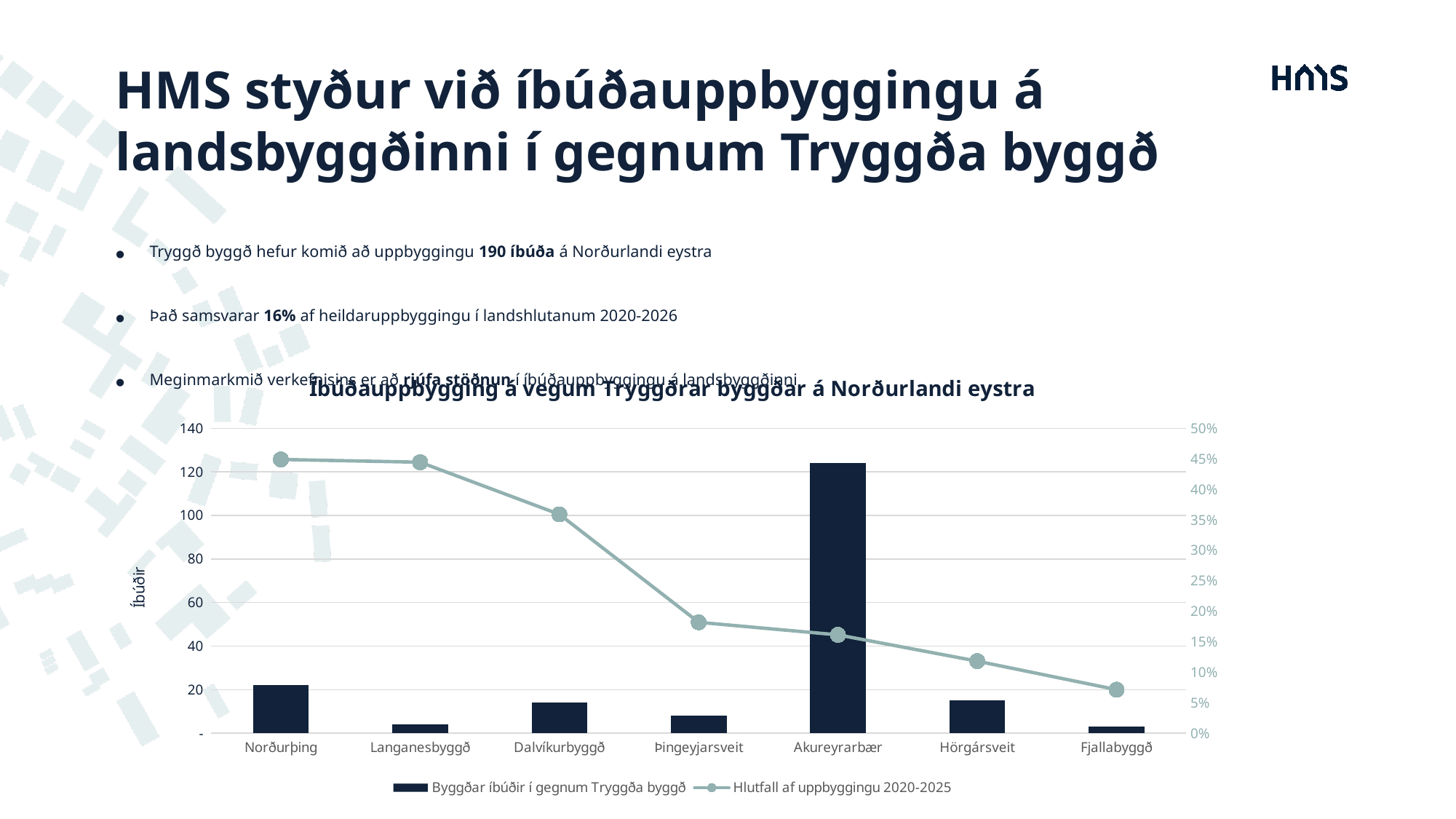
Which has the larger bar, Norðurþing or Dalvíkurbyggð? Norðurþing How many series does the chart legend list? 2 Does the 'Hlutfall af uppbyggingu 2020-2025' line rise or fall from left to right across the x axis? Fall What type of chart is shown on the slide? Combined bar and line chart Is the 'Hlutfall af uppbyggingu 2020-2025' value for Norðurþing greater or less than 40%? greater What is the title of the left vertical axis of the chart? Íbúðir Is the bar value for Norðurþing greater or less than 40? less Is the 'Hlutfall af uppbyggingu 2020-2025' value for Fjallabyggð greater or less than 10%? less How many municipalities are shown on the x axis of the chart? 7 Which municipality has the lowest value on the 'Hlutfall af uppbyggingu 2020-2025' line? Fjallabyggð Which municipality has the highest bar for 'Byggðar íbúðir í gegnum Tryggða byggð'? Akureyrarbær